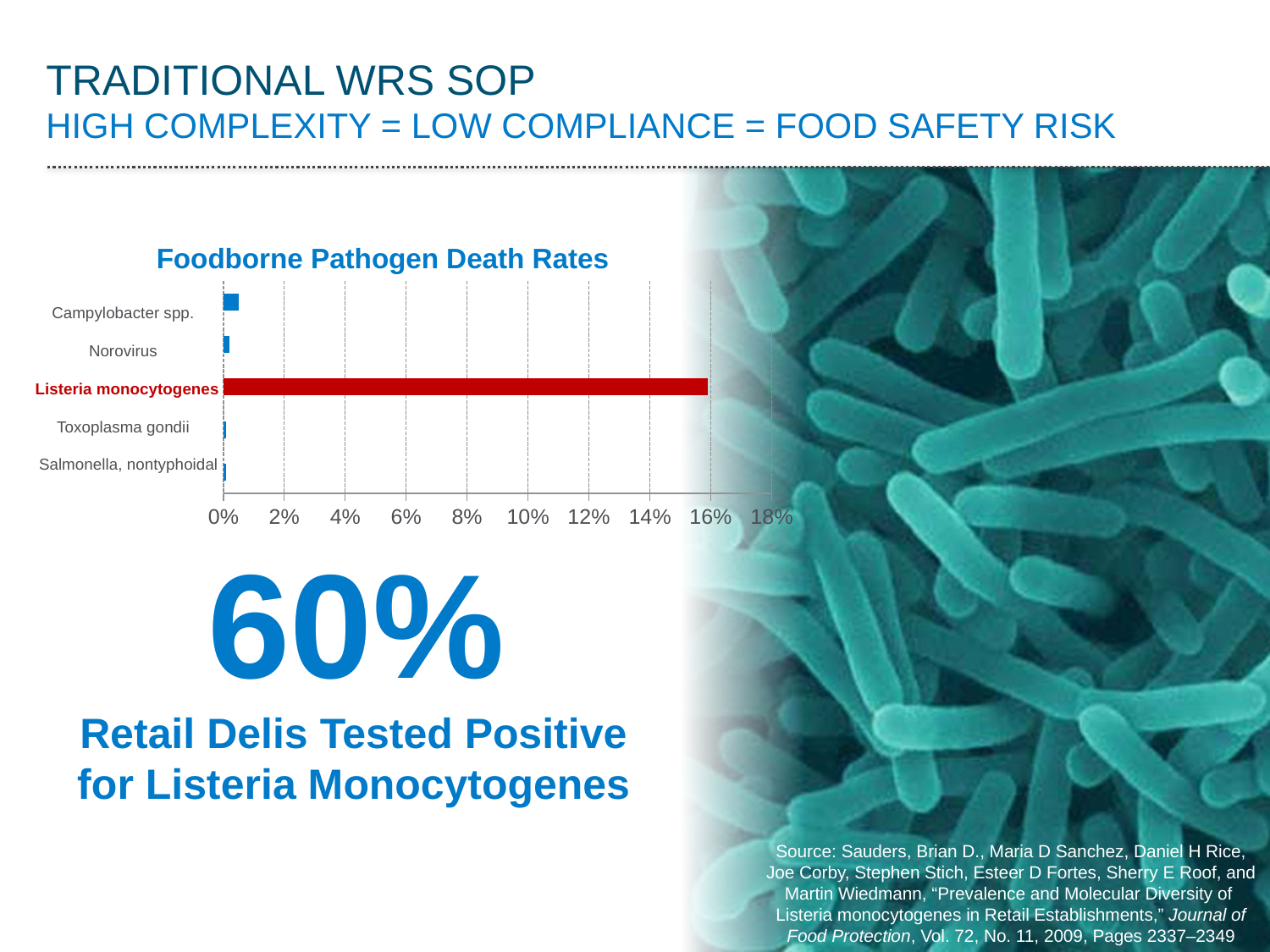
Which has a higher death rate, Campylobacter spp. or Norovirus? Campylobacter spp. What is the title of the chart? Foodborne Pathogen Death Rates Is the death rate for Listeria monocytogenes greater or less than 14%? greater Is the death rate for Listeria monocytogenes greater or less than 18%? less Which has a higher death rate, Listeria monocytogenes or Campylobacter spp.? Listeria monocytogenes Is the death rate for Norovirus greater or less than 2%? less What kind of chart is shown on the slide? bar chart Which pathogen has the highest death rate in the chart? Listeria monocytogenes What is the highest value shown on the chart's x axis? 18% What colour is the bar for Listeria monocytogenes? red How many pathogens are listed in the chart? 5